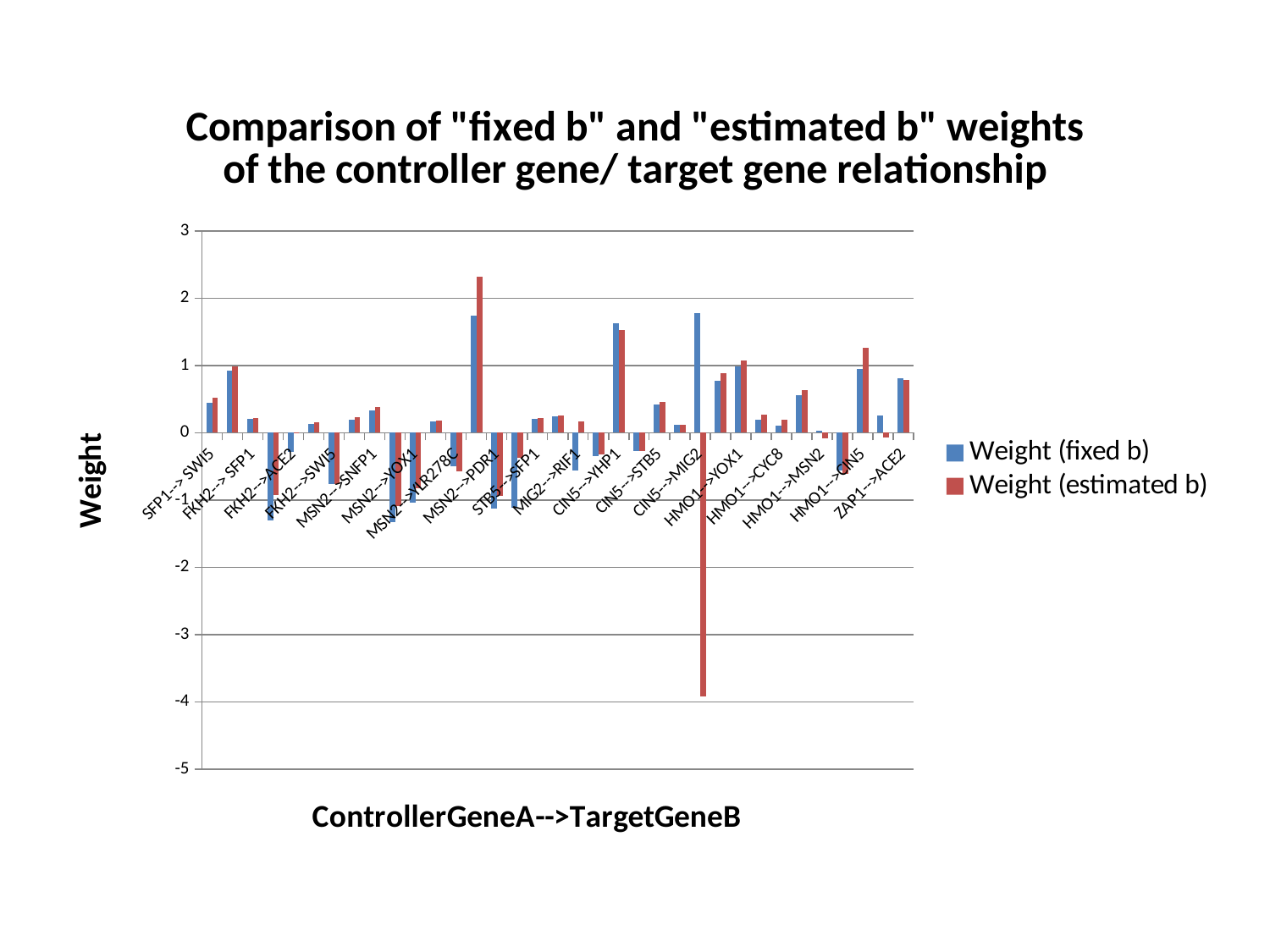
For CIN5-->MIG2, which is larger: Weight (fixed b) or Weight (estimated b)? Weight (fixed b) Is the Weight (fixed b) value for CIN5-->MIG2 greater or less than 1? greater Which category has the lowest Weight (estimated b) value? CIN5-->MIG2 What is the title of the x axis? ControllerGeneA-->TargetGeneB Is the Weight (estimated b) value for CIN5-->MIG2 greater or less than -3? less Is the Weight (estimated b) value for MSN2-->PDR1 greater or less than 2? less What are the two series named in the legend? Weight (fixed b) and Weight (estimated b) How many series does the legend list? 2 What kind of chart is shown on the slide? bar chart What is the lowest value shown on the vertical axis? -5